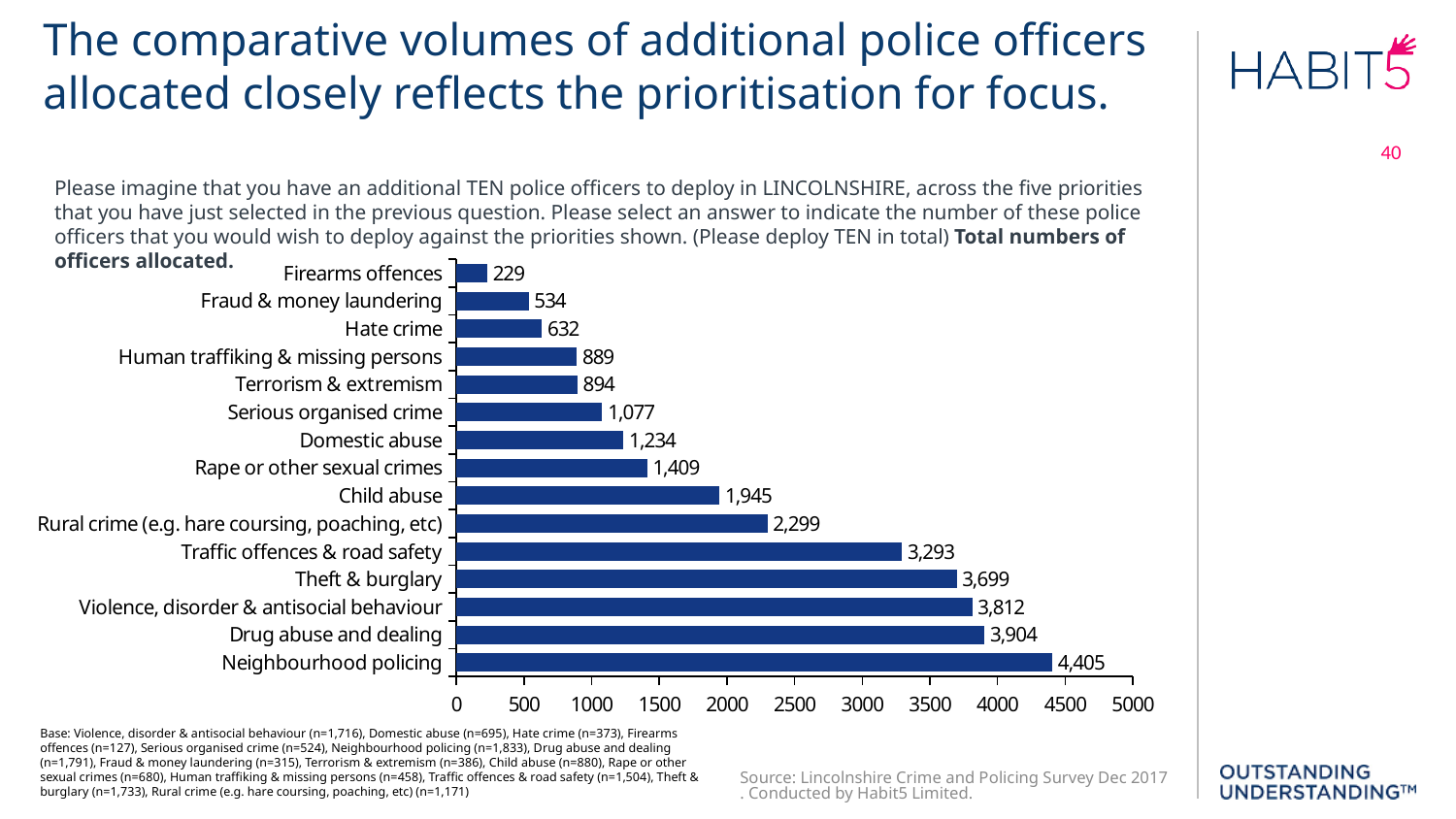
What is the difference between the values for Terrorism & extremism and Human trafficking & missing persons? 5 Which category has the lowest value? Firearms offences What is the value for Rural crime (e.g. hare coursing, poaching, etc)? 2,299 How many categories are shown in the chart? 15 What is the value for Neighbourhood policing? 4,405 What is the highest value shown on the horizontal axis? 5000 Which category has the highest value? Neighbourhood policing Is the value for Traffic offences & road safety greater or less than 3000? greater Which is larger, the value for Child abuse or the value for Rape or other sexual crimes? Child abuse What kind of chart is shown on the slide? Bar chart What is the value for Hate crime? 632 What is the difference between the values for Drug abuse and dealing and Theft & burglary? 205